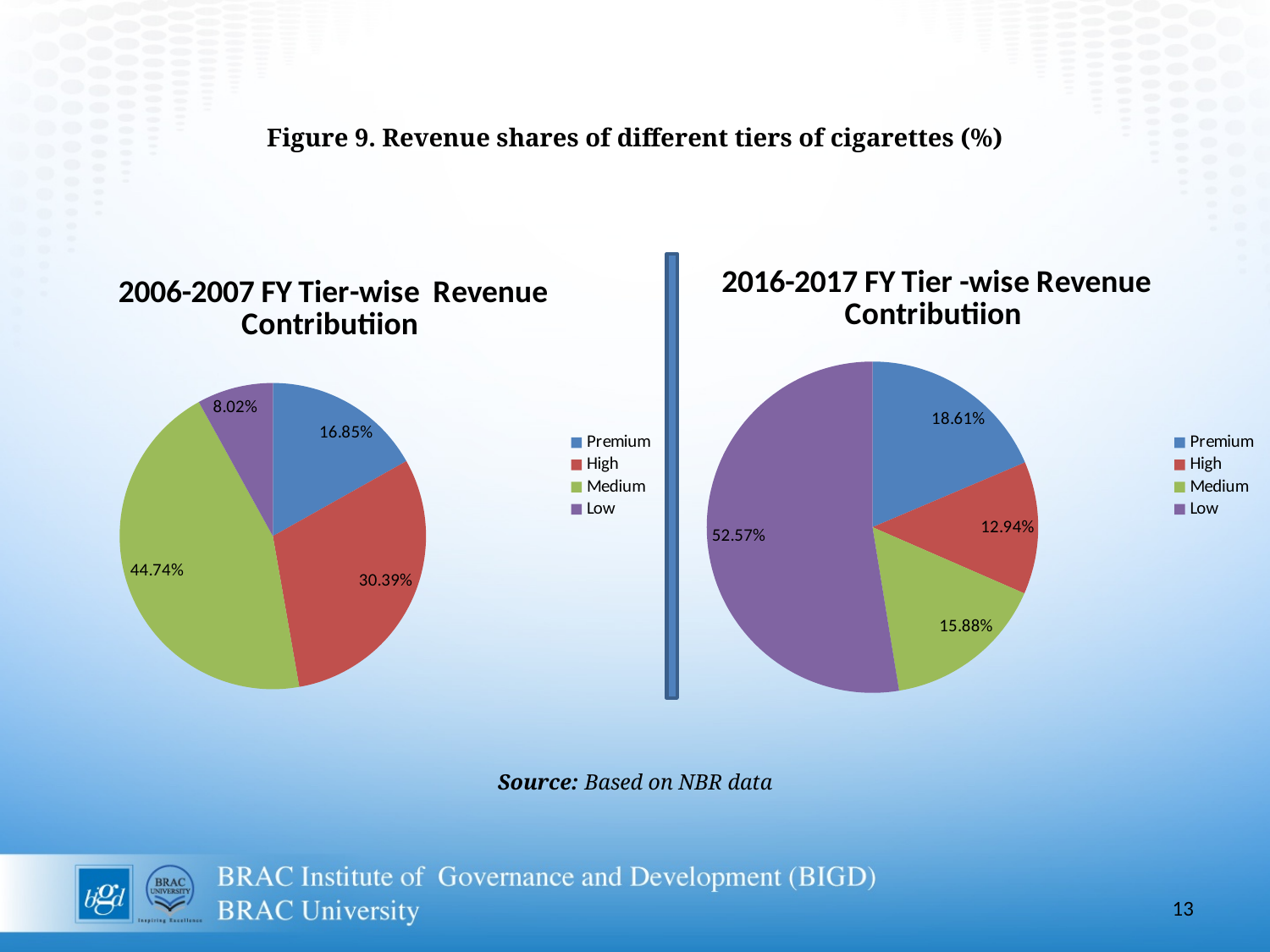
In the 2006-2007 FY Tier-wise Revenue Contribution chart, which tier has the largest share? Medium In the 2006-2007 FY Tier-wise Revenue Contribution chart, what is the share for Medium? 44.74% What type of chart is used for the 2016-2017 FY Tier-wise Revenue Contribution? Pie chart In the 2006-2007 FY Tier-wise Revenue Contribution chart, what is the share for Low? 8.02% In the 2016-2017 FY Tier-wise Revenue Contribution chart, which tier has the largest share? Low In the 2016-2017 FY Tier-wise Revenue Contribution chart, what is the share for High? 12.94% In the 2016-2017 FY Tier-wise Revenue Contribution chart, which is larger, the Premium share or the Medium share? Premium In the 2016-2017 FY Tier-wise Revenue Contribution chart, what is the share for Low? 52.57% In the 2006-2007 FY Tier-wise Revenue Contribution chart, what is the difference between the High and Premium shares? 13.54% How many slices does the 2006-2007 FY Tier-wise Revenue Contribution pie chart have? 4 In the 2016-2017 FY Tier-wise Revenue Contribution chart, which colour represents the Low tier? Purple In the 2016-2017 FY Tier-wise Revenue Contribution chart, which tier has the smallest share? High